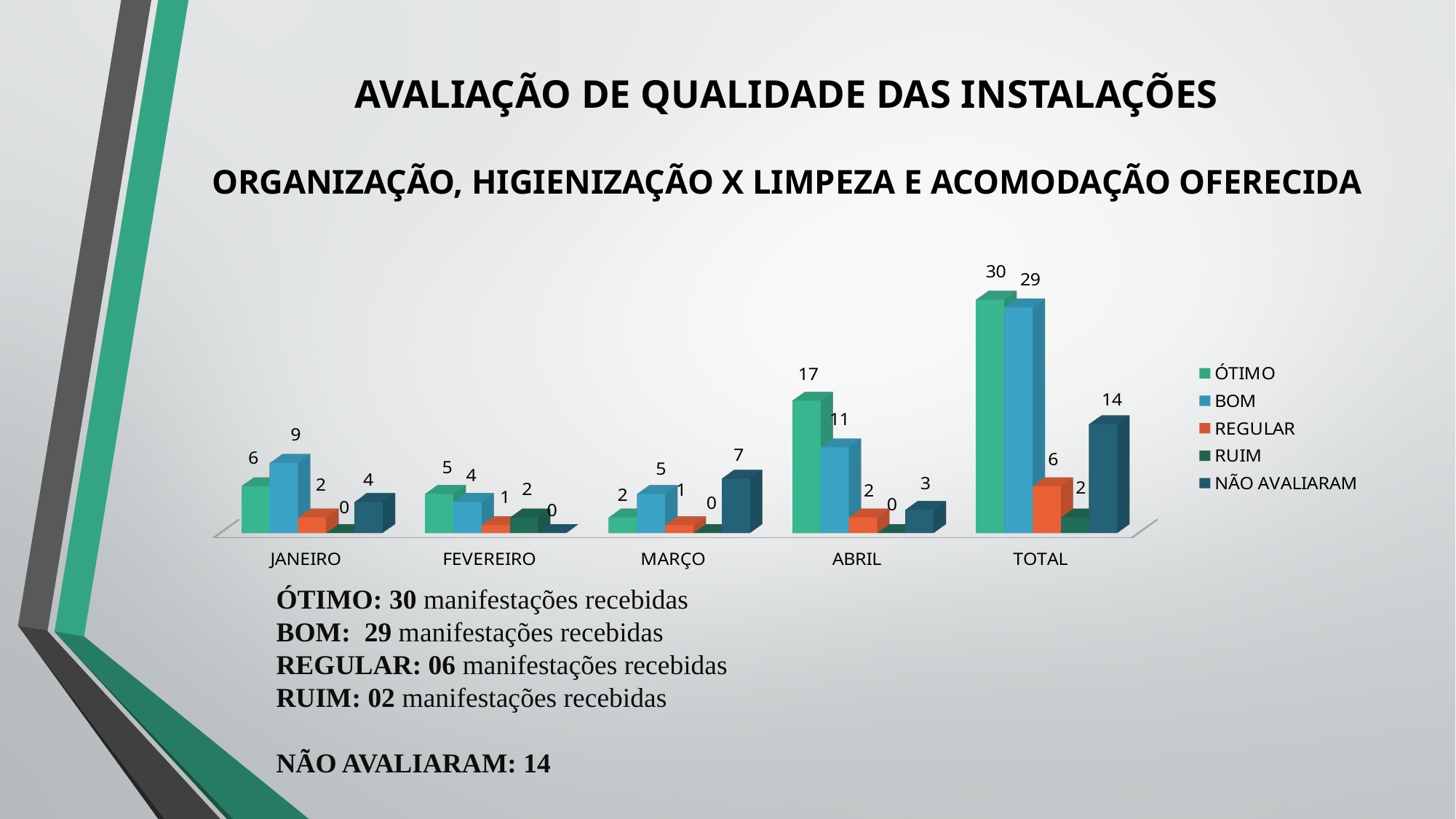
Which is larger in JANEIRO, ÓTIMO or BOM? BOM What type of chart is shown on the slide? bar chart What is the value for RUIM in FEVEREIRO? 2 What is the value for BOM in JANEIRO? 9 In which month is the ÓTIMO value lowest? MARÇO Which series is shown in orange in the legend? REGULAR What is the value for NÃO AVALIARAM in MARÇO? 7 How many categories are shown on the x axis? 5 In which month is the ÓTIMO value highest (excluding TOTAL)? ABRIL What is the difference between the ÓTIMO and BOM values in the TOTAL category? 1 How many series does the legend list? 5 What is the value for ÓTIMO in ABRIL? 17